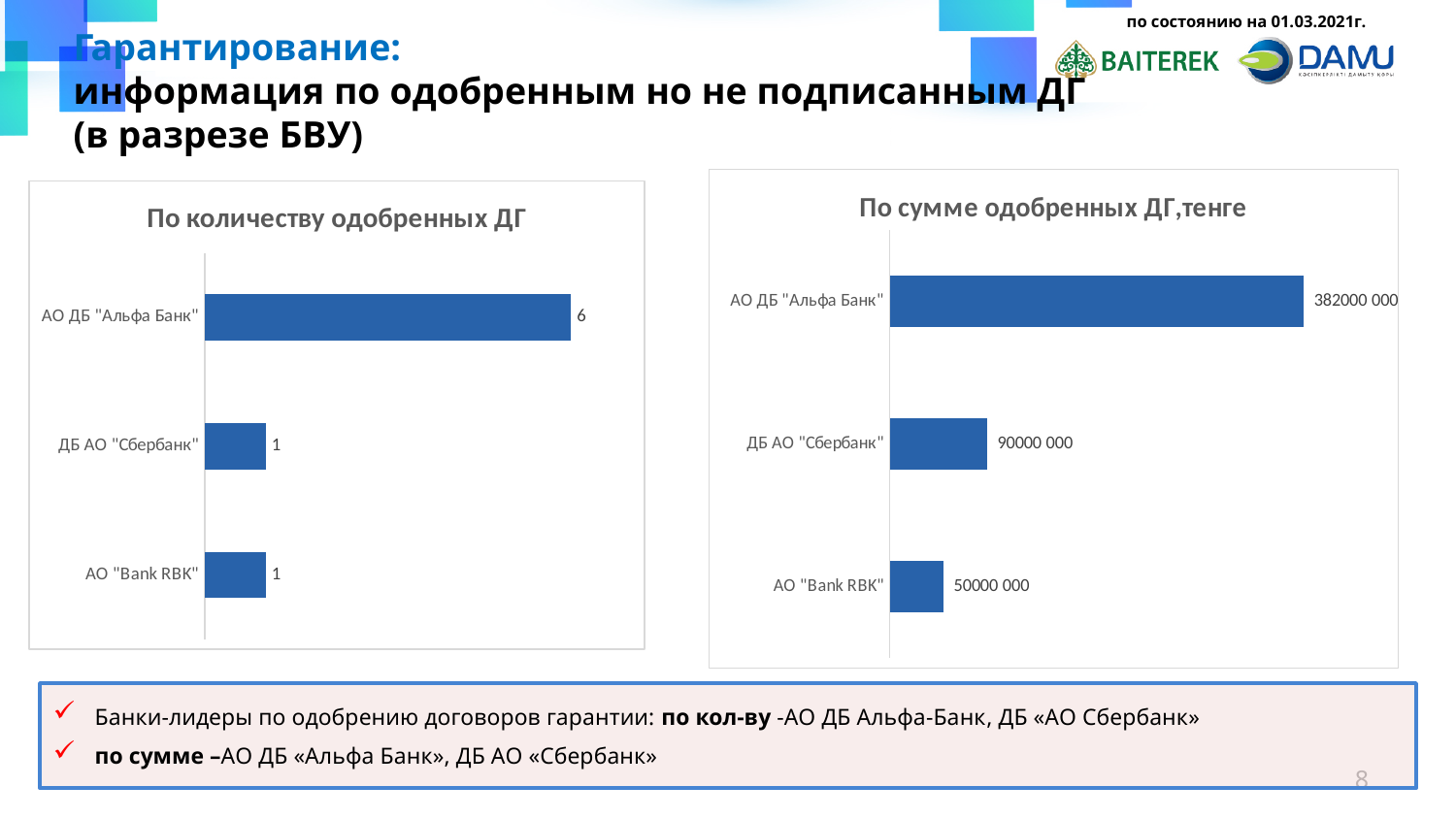
In the chart "По количеству одобренных ДГ", what is the value for АО ДБ "Альфа Банк"? 6 What type of chart is "По сумме одобренных ДГ,тенге"? Bar chart In the chart "По сумме одобренных ДГ,тенге", what is the value for ДБ АО "Сбербанк"? 90000 000 In the chart "По сумме одобренных ДГ,тенге", which is larger: ДБ АО "Сбербанк" or АО "Bank RBK"? ДБ АО "Сбербанк" In the chart "По сумме одобренных ДГ,тенге", what is the difference between ДБ АО "Сбербанк" and АО "Bank RBK"? 40000 000 In the chart "По количеству одобренных ДГ", what is the value for ДБ АО "Сбербанк"? 1 In the chart "По сумме одобренных ДГ,тенге", what is the value for АО "Bank RBK"? 50000 000 In the chart "По количеству одобренных ДГ", how many banks are shown? 3 In the chart "По количеству одобренных ДГ", what is the difference between АО ДБ "Альфа Банк" and АО "Bank RBK"? 5 In the chart "По сумме одобренных ДГ,тенге", what is the value for АО ДБ "Альфа Банк"? 382000 000 In the chart "По количеству одобренных ДГ", which bank has the highest value? АО ДБ "Альфа Банк" In the chart "По сумме одобренных ДГ,тенге", which bank has the lowest value? АО "Bank RBK"